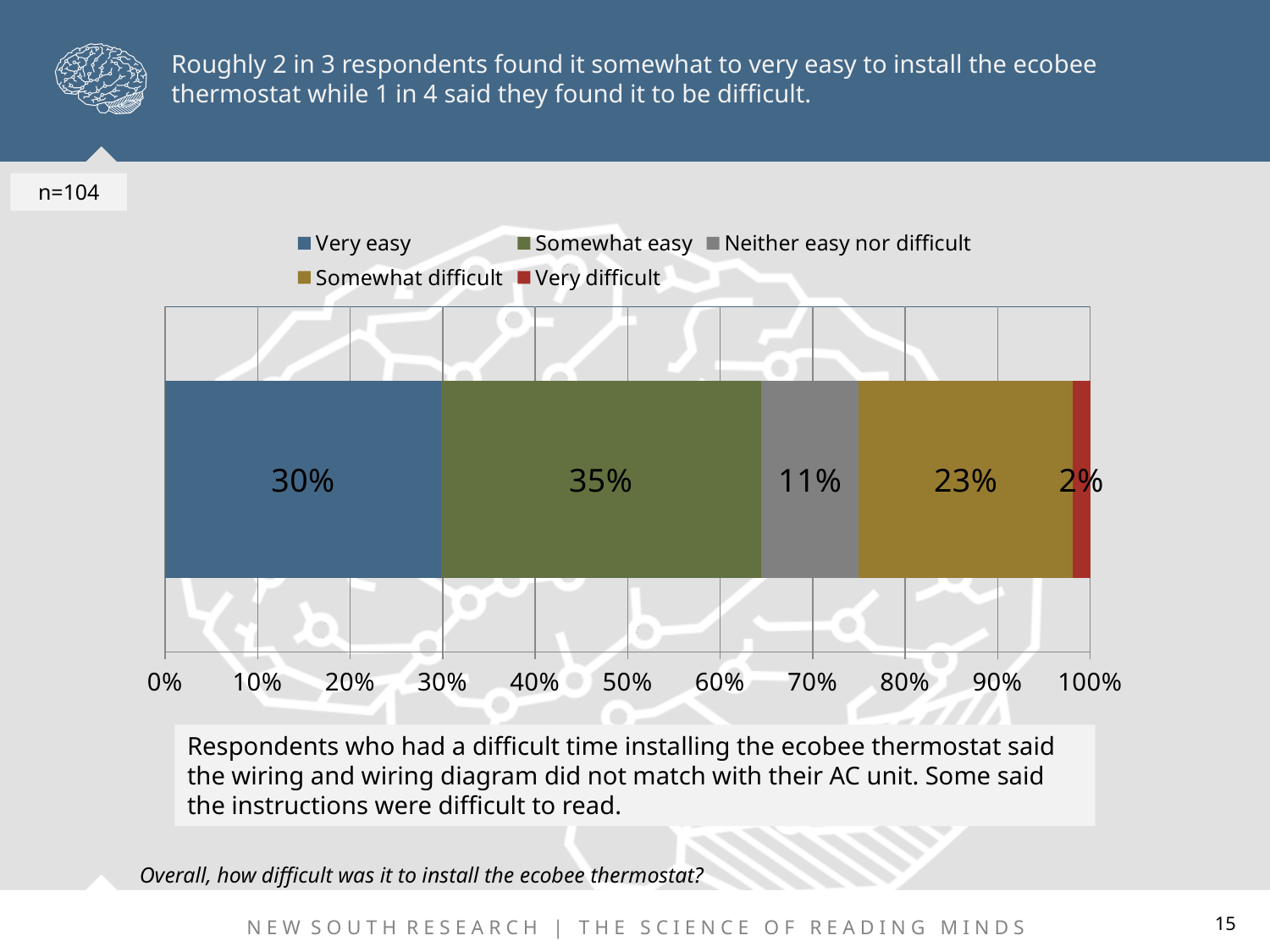
What percentage of respondents said installing the thermostat was neither easy nor difficult? 11% What is the difference in percentage points between the somewhat easy and very easy segments? 5% What percentage of respondents said installing the thermostat was somewhat difficult? 23% What percentage of respondents said installing the ecobee thermostat was somewhat easy? 35% What percentage of respondents said installing the thermostat was very difficult? 2% Which response category has the smallest share of respondents? Very difficult How many series does the legend list? 5 What is the combined percentage of respondents who found installation very easy or somewhat easy? 65% What percentage of respondents said installing the ecobee thermostat was very easy? 30% What kind of chart is shown on the slide? Stacked bar chart Which response category has the largest share of respondents? Somewhat easy Which is larger, the somewhat difficult segment or the neither easy nor difficult segment? Somewhat difficult